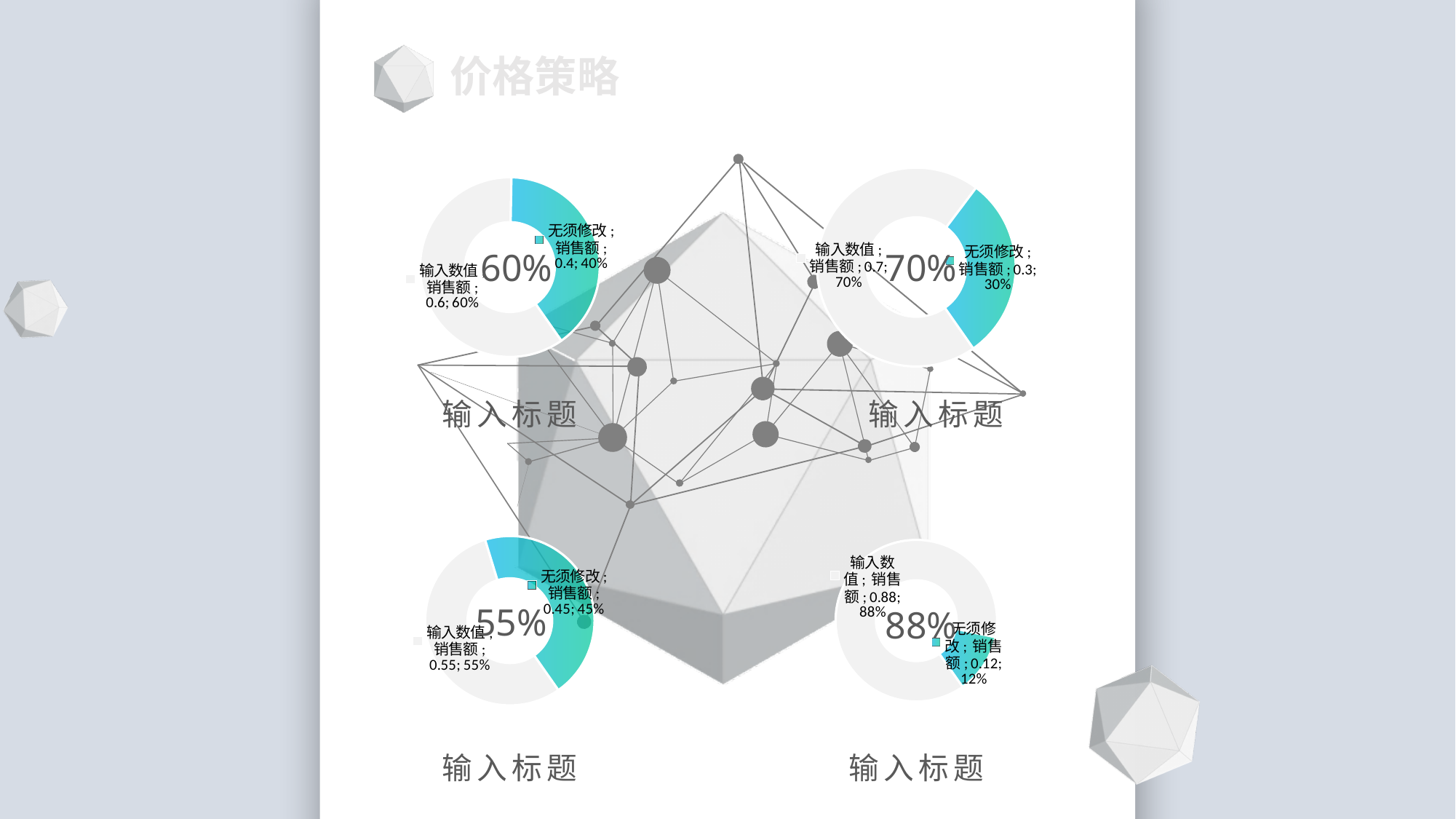
In the bottom-left doughnut chart, which slice is larger, 输入数值 or 无须修改? 输入数值 In the bottom-right doughnut chart, what percentage is shown for 无须修改? 12% How many slices does the bottom-right doughnut chart have? 2 What large percentage is printed in the centre of the bottom-left doughnut chart? 55% In the top-right doughnut chart, what value is shown for 无须修改? 0.3 In the top-left doughnut chart, what value is shown for 输入数值? 0.6 In the bottom-left doughnut chart, what percentage is shown for 无须修改? 45% In the top-left doughnut chart, what percentage is shown for 无须修改? 40% In the top-right doughnut chart, what is the difference between the 输入数值 and 无须修改 percentages? 40% What kind of chart is shown in the top-left of the slide? Doughnut chart In the top-right doughnut chart, what percentage is shown for 输入数值? 70% In the bottom-right doughnut chart, what value is shown for 输入数值? 0.88